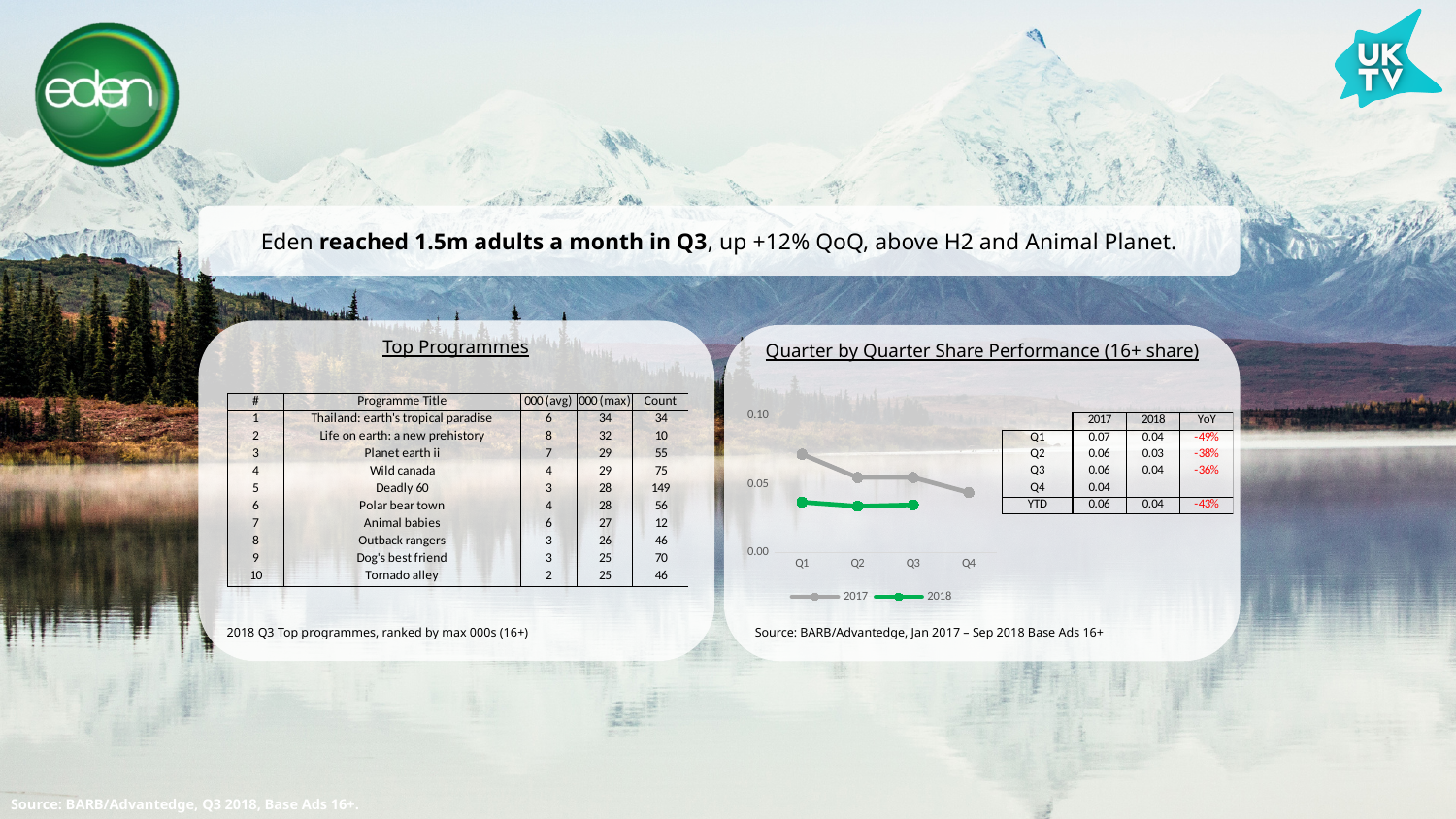
In the Quarter by Quarter Share Performance chart, is the 2018 value for Q2 greater or less than 0.05? less In the Quarter by Quarter Share Performance chart, is the 2017 value for Q1 greater or less than 0.05? greater In the Quarter by Quarter Share Performance chart, what colour is the 2018 line? green How many quarters are shown on the x axis of the Quarter by Quarter Share Performance chart? 4 In the Quarter by Quarter Share Performance chart, does the 2017 line rise or fall from Q1 to Q4? fall How many series does the legend of the Quarter by Quarter Share Performance chart list? 2 According to the table beside the Quarter by Quarter Share Performance chart, what is the YoY change for Q1? -49% According to the table beside the Quarter by Quarter Share Performance chart, what is the 2017 share for Q1? 0.07 In the Quarter by Quarter Share Performance chart, which quarter has the highest 2017 value? Q1 In the Quarter by Quarter Share Performance chart, which is larger at Q1: the 2017 value or the 2018 value? 2017 According to the table beside the Quarter by Quarter Share Performance chart, what is the 2018 share for Q3? 0.04 What kind of chart is the Quarter by Quarter Share Performance chart? line chart